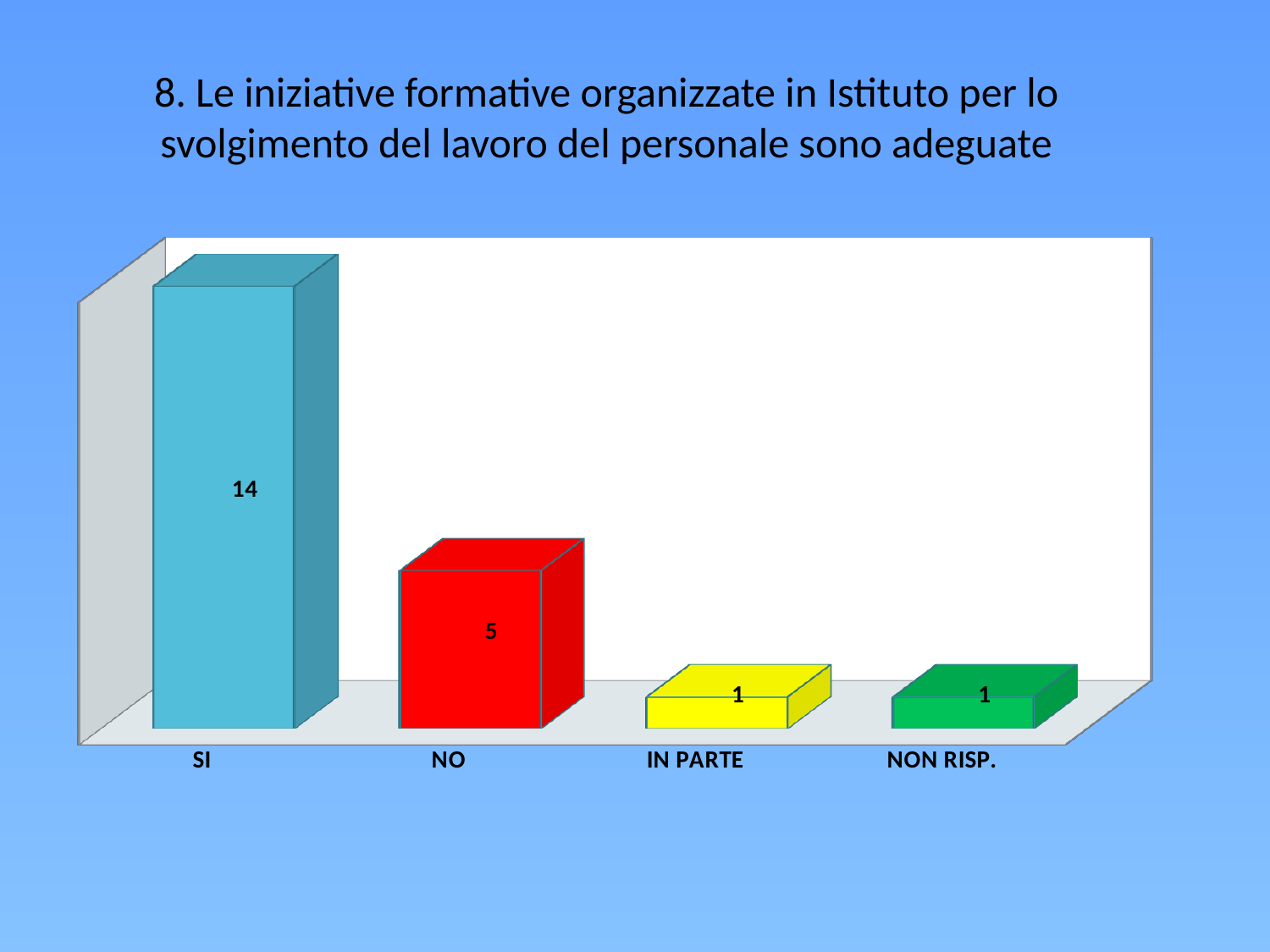
Which category has the highest value? SI What is the value for NON RISP.? 1 What is the value for NO? 5 What colour is the bar for NO? red What is the value for SI? 14 What is the value for IN PARTE? 1 How many categories are shown on the x axis? 4 Which is larger, the value for NO or the value for NON RISP.? NO What is the difference between the values for SI and NO? 9 What colour is the bar for IN PARTE? yellow What is the difference between the values for NO and IN PARTE? 4 What kind of chart is shown on the slide? bar chart